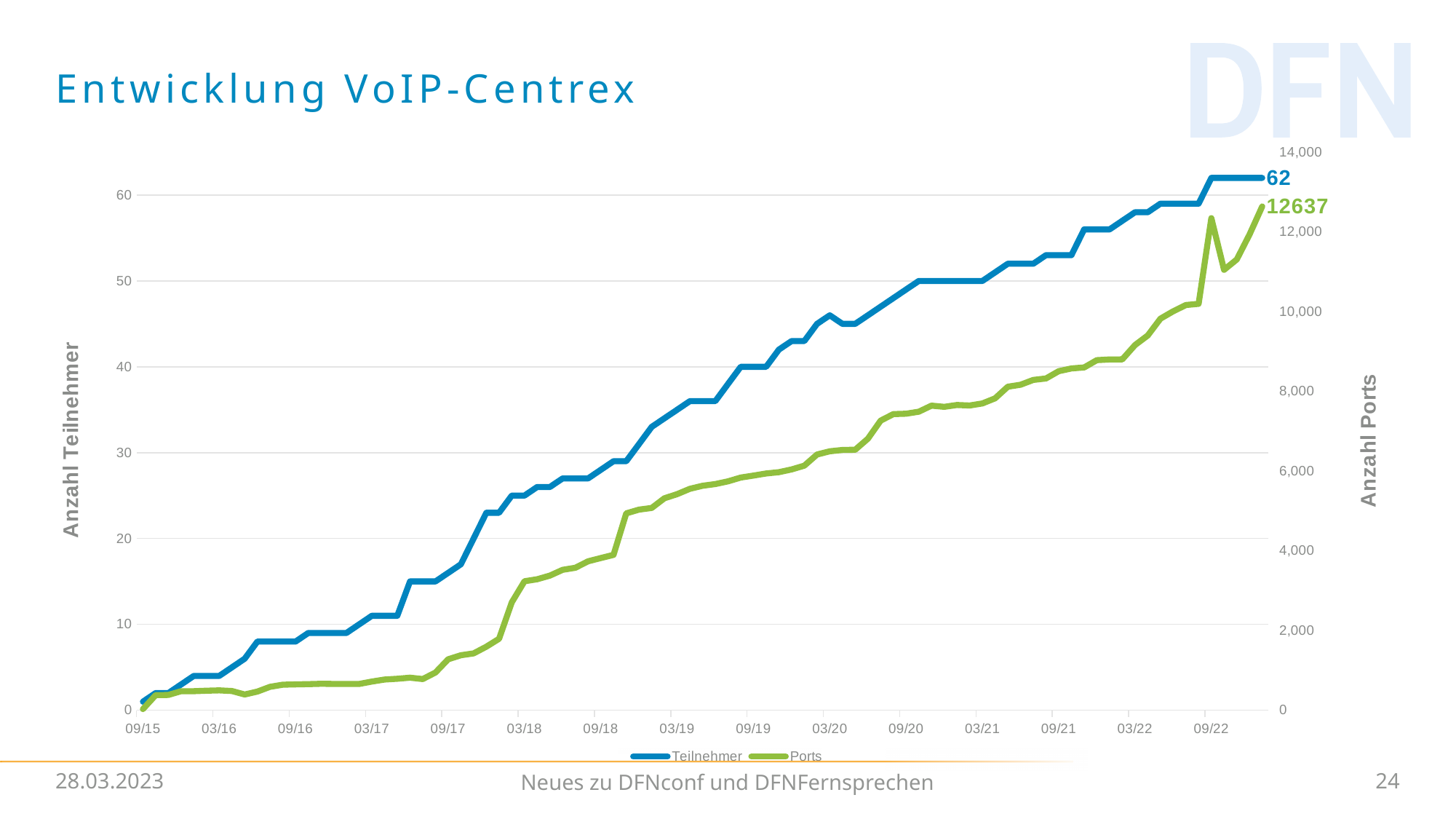
Is the Teilnehmer value at 09/18 greater or less than 30? less Do the values of the Ports series generally rise or fall from 09/15 to the end of the x axis? rise Is the Teilnehmer value at 03/20 greater or less than 40? greater What is the title of the right-hand vertical axis? Anzahl Ports What type of chart is shown on the slide? line chart How many series does the legend list? 2 Which series is drawn in green? Ports What is the final labelled value of the Teilnehmer series? 62 What is the highest value reached by the Teilnehmer series? 62 Is the Teilnehmer value at 09/16 greater or less than 10? less What is the final labelled value of the Ports series? 12637